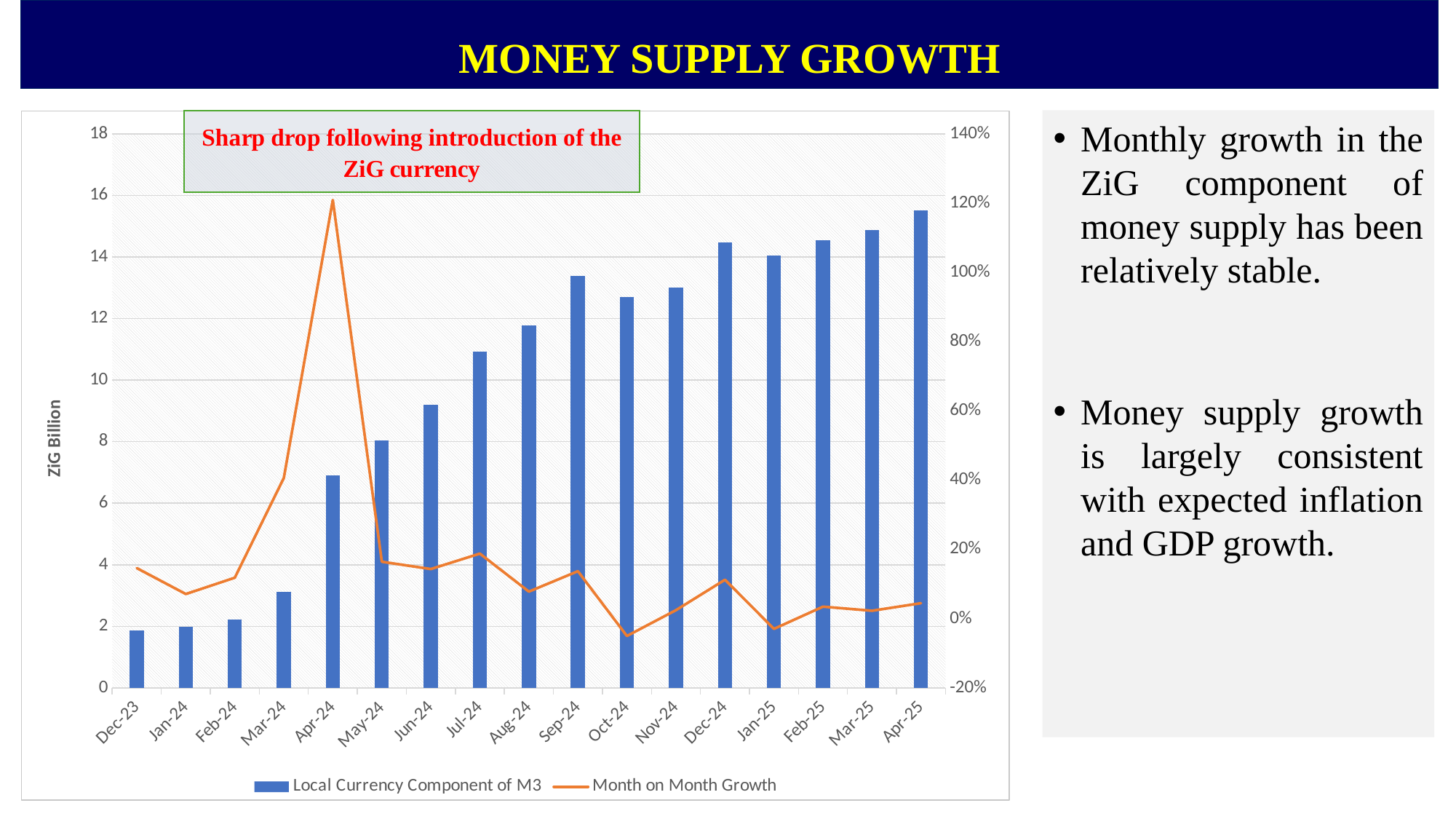
Which month has the highest bar for Local Currency Component of M3? Apr-25 What kind of chart is shown on the slide? A combined bar and line chart How many months are plotted along the x axis? 17 What does the annotation box on the chart say? Sharp drop following introduction of the ZiG currency In which month does the Month on Month Growth line reach its peak? Apr-24 Which month has the larger Local Currency Component of M3 bar, Sep-24 or Oct-24? Sep-24 Which month has the lowest bar for Local Currency Component of M3? Dec-23 How many series does the legend list? 2 Do the Local Currency Component of M3 bars generally rise or fall from Dec-23 to Apr-25? Rise Is the Local Currency Component of M3 bar for Sep-24 greater or less than 12 ZiG Billion? greater Is the Local Currency Component of M3 bar for Apr-24 greater or less than 8 ZiG Billion? less Is the Month on Month Growth value for Apr-24 greater or less than 100%? greater